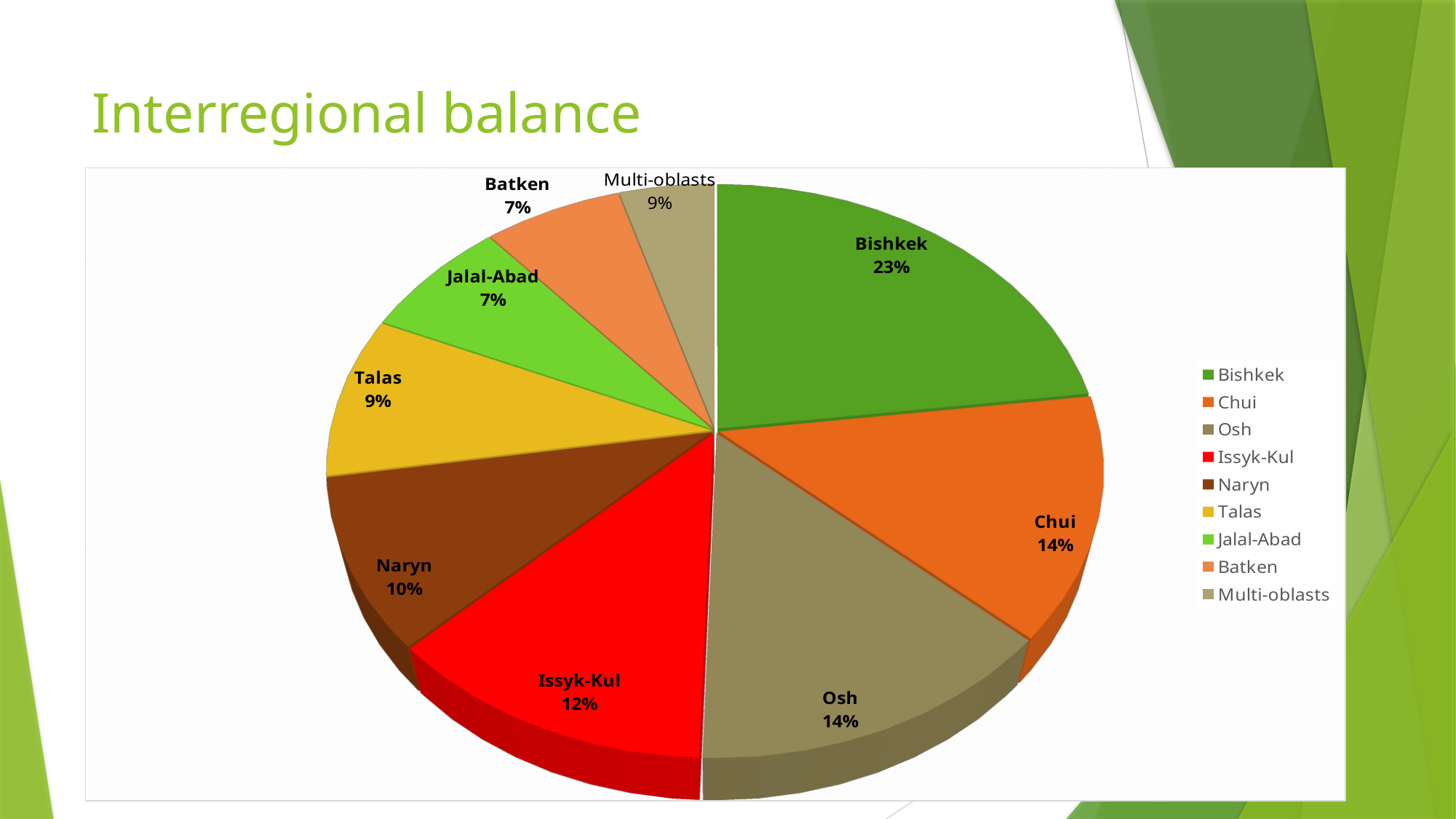
How many entries does the legend list? 9 How many slices does the pie chart have? 9 Which region has the largest slice of the pie? Bishkek Which is larger, the share for Naryn or the share for Talas? Naryn What is the difference between the shares of Issyk-Kul and Jalal-Abad? 5% What share of the pie does Bishkek have? 23% What kind of chart is shown on the slide? Pie chart What is the value shown for Naryn? 10% What is the value shown for Multi-oblasts? 9% What is the title of the slide containing the chart? Interregional balance What is the difference between the shares of Bishkek and Chui? 9% What is the value shown for Issyk-Kul? 12%